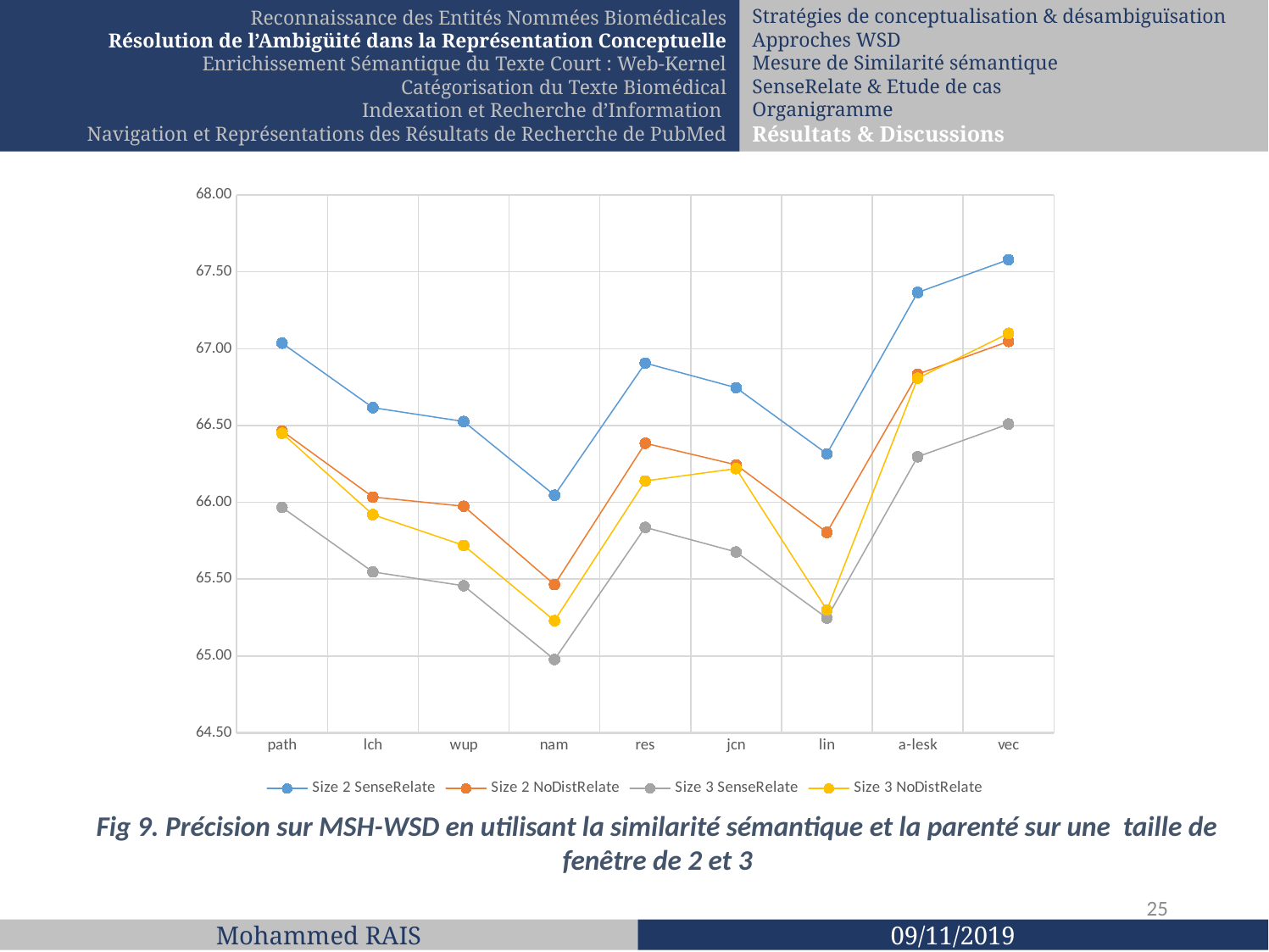
For the Size 2 SenseRelate series, which category has the highest value? vec Is the value for Size 3 SenseRelate at lin greater or less than 65.50? less How many categories are shown along the x axis of the chart? 9 How many series does the chart legend list? 4 Does the Size 2 SenseRelate series rise or fall from lin to vec? Rise Is the value for Size 3 NoDistRelate at nam greater or less than 65.50? less For the Size 2 NoDistRelate series, which category has the lowest value? nam Which series is drawn in blue in the chart? Size 2 SenseRelate Is the value for Size 2 SenseRelate at a-lesk greater or less than 67.00? greater At path, which is larger: Size 2 SenseRelate or Size 3 SenseRelate? Size 2 SenseRelate For the Size 3 SenseRelate series, which category has the lowest value? nam What kind of chart is shown on the slide? Line chart